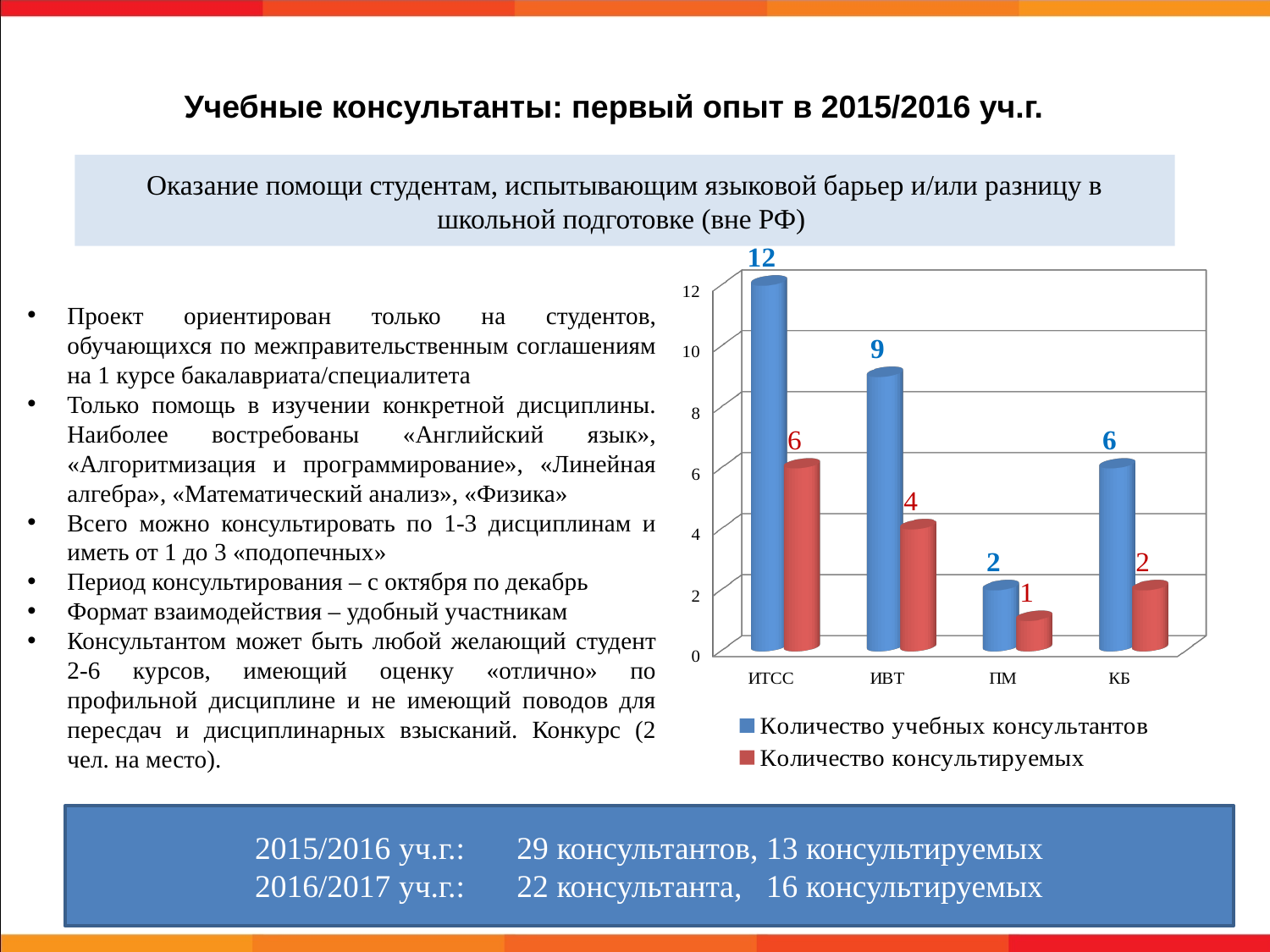
Which colour represents «Количество консультируемых» in the chart? Red What is the value of «Количество учебных консультантов» for ИТСС? 12 Which is larger: «Количество консультируемых» for ИТСС or for КБ? ИТСС How many series does the chart legend list? 2 Which category has the highest value for «Количество учебных консультантов»? ИТСС What kind of chart is shown on the slide? Bar chart What is the value of «Количество консультируемых» for ИВТ? 4 What is the value of «Количество консультируемых» for ПМ? 1 What is the difference between «Количество учебных консультантов» for ИВТ and for КБ? 3 How many categories are shown on the x axis of the chart? 4 What is the difference between «Количество учебных консультантов» and «Количество консультируемых» for ИТСС? 6 Which category has the lowest value for «Количество консультируемых»? ПМ